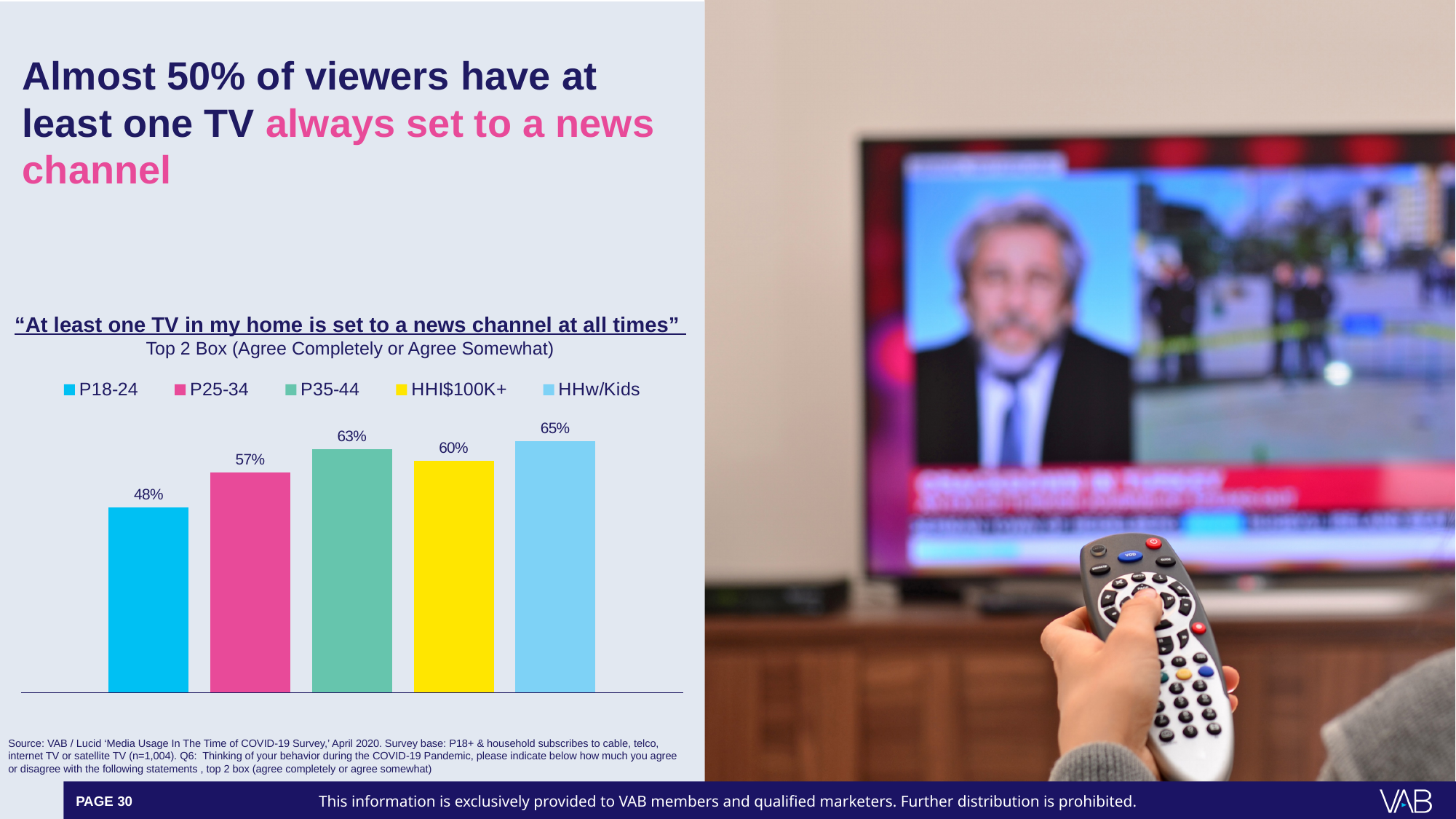
What is the value shown for HHI$100K+? 60% What is the value shown for P35-44? 63% What colour is the bar for HHI$100K+? Yellow What percentage of P18-24 agree that at least one TV in their home is set to a news channel at all times? 48% How many entries does the legend list? 5 What kind of chart is shown on the slide? Bar chart How many groups are plotted in the chart? 5 Which group has the lowest percentage in the chart? P18-24 What is the difference in percentage points between P35-44 and P25-34? 6 Which is larger, the value for P25-34 or the value for HHI$100K+? HHI$100K+ What is the difference in percentage points between HHw/Kids and P18-24? 17 Which group has the highest percentage in the chart? HHw/Kids